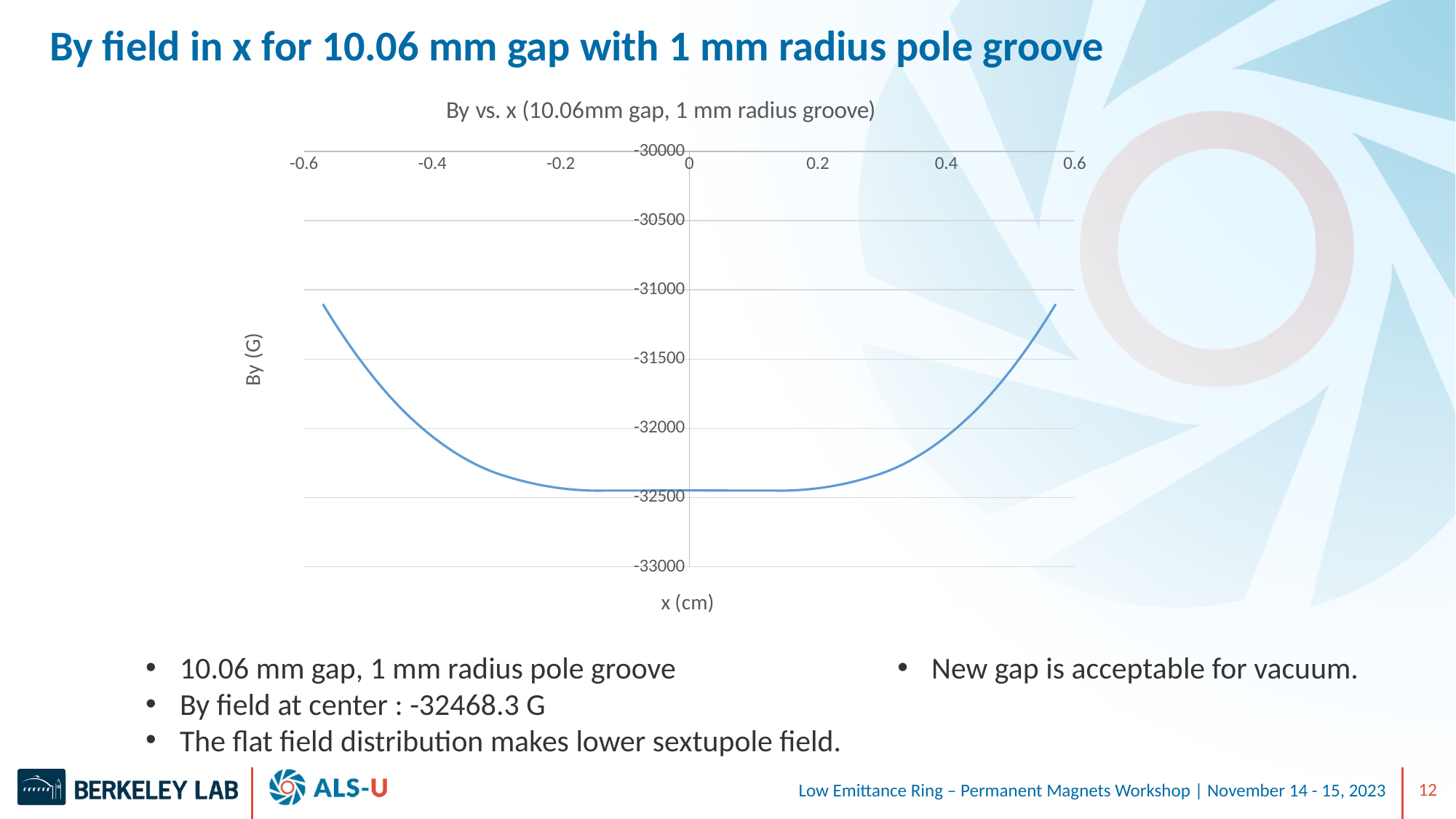
Is the value of By at x = 0.6 greater or less than -31000? less Is the value of By at x = 0.4 greater or less than -32500? greater What is the label of the vertical axis of the chart? By (G) Does By rise or fall as x goes from 0 to 0.6? rise Is the value of By at x = 0 greater or less than -32000? less How many data series are plotted on the chart? 1 According to the slide, what is the By field at the center (x = 0)? -32468.3 G What kind of chart is shown on the slide? line chart Is the value of By at x = 0 larger or smaller than the value at x = -0.6? smaller What is the title of the chart? By vs. x (10.06mm gap, 1 mm radius groove) Does By rise or fall as x goes from -0.6 to 0? fall